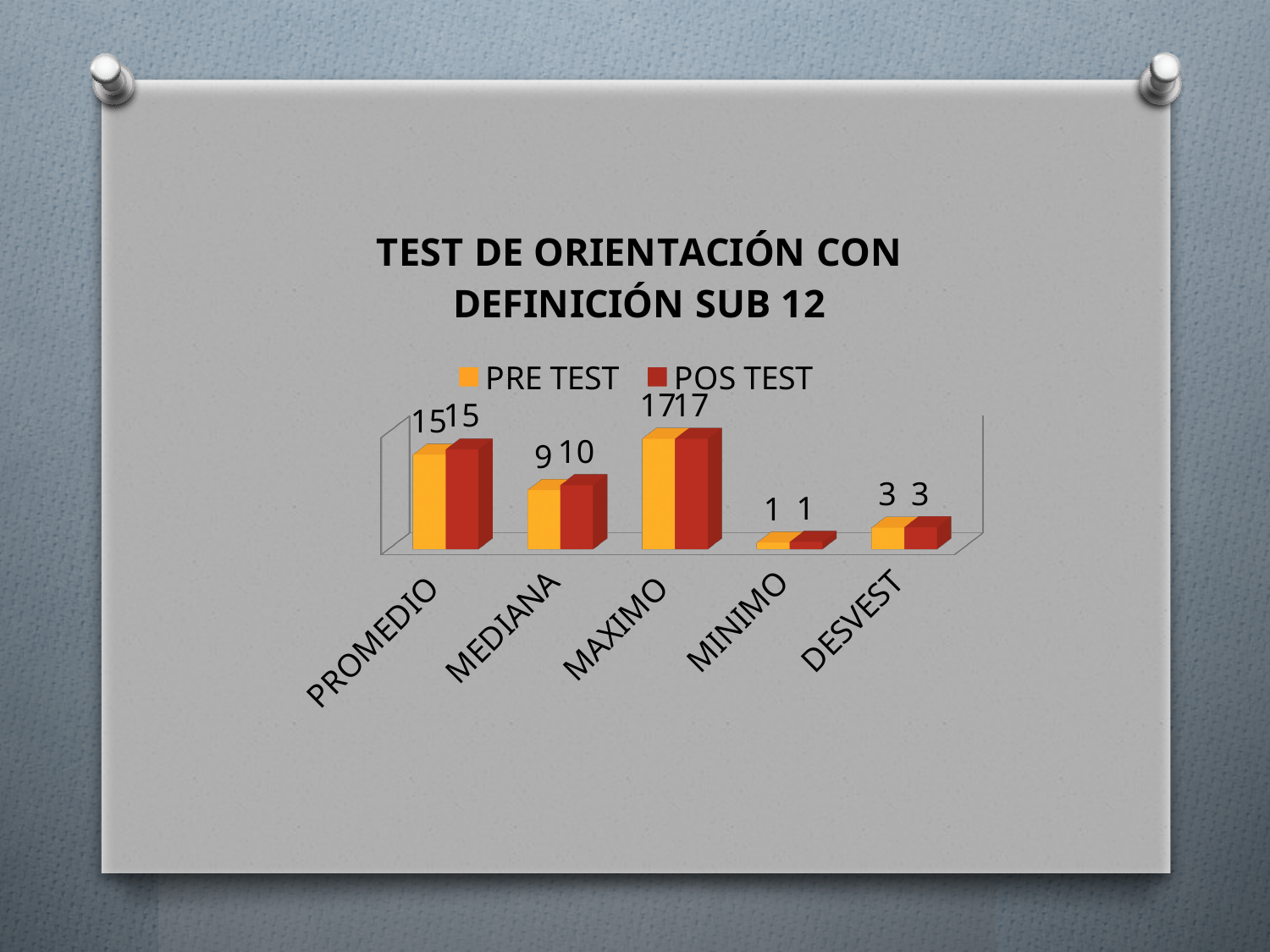
What is the difference between the POS TEST and PRE TEST values for MEDIANA? 1 What is the difference between the PRE TEST values for MAXIMO and PROMEDIO? 2 How many series does the legend list? 2 What is the PRE TEST value for PROMEDIO? 15 Which category has the highest PRE TEST value? MAXIMO What kind of chart is shown on the slide? Bar chart What is the PRE TEST value for MAXIMO? 17 What is the POS TEST value for DESVEST? 3 How many categories are shown on the x axis? 5 Which is larger, the PRE TEST value for MEDIANA or the POS TEST value for MEDIANA? POS TEST What is the POS TEST value for MEDIANA? 10 Which category has the lowest POS TEST value? MINIMO